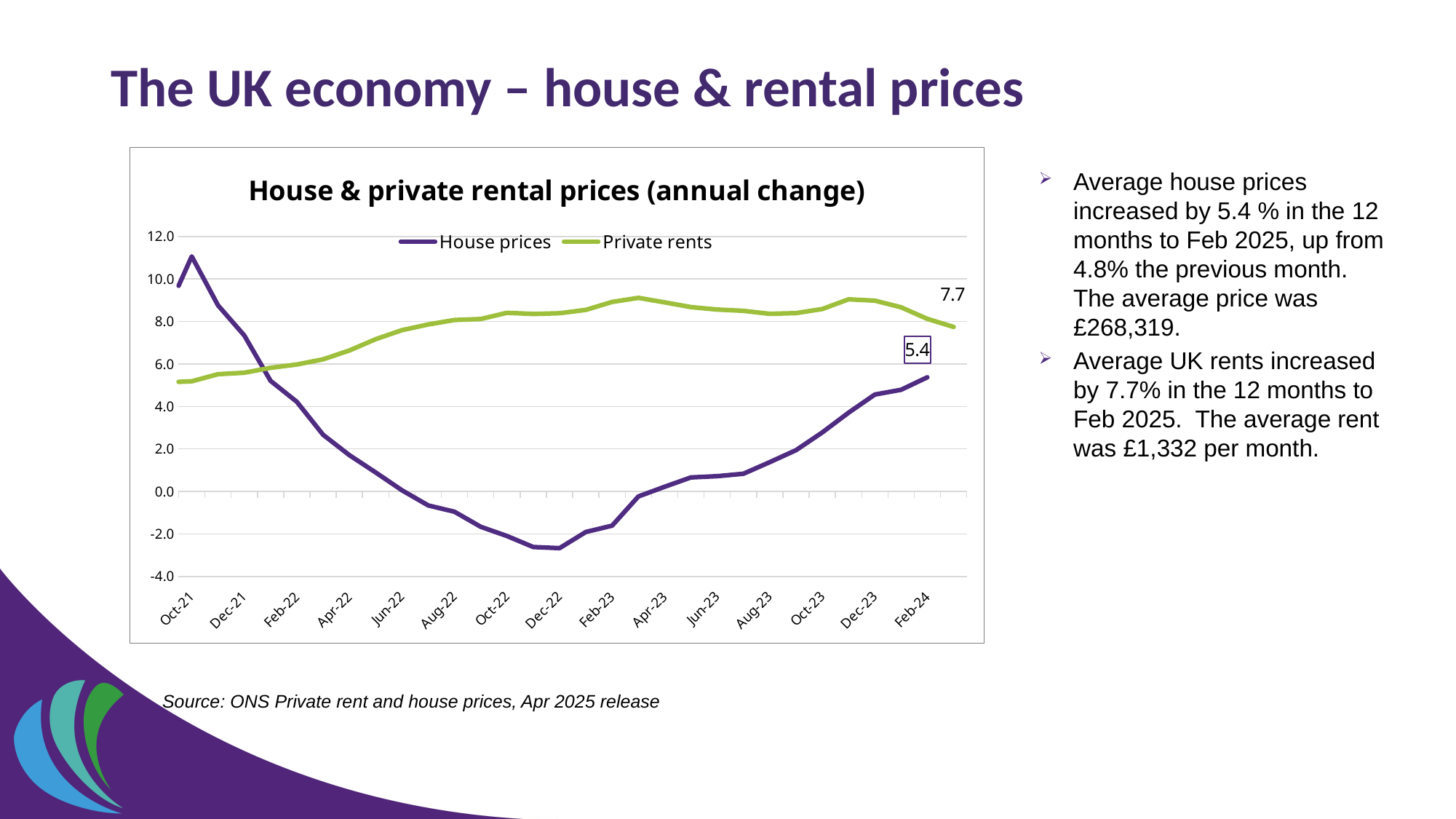
What is the difference between the final labelled values of Private rents (7.7) and House prices (5.4)? 2.3 Is the House prices value at Dec-22 greater or less than -2.0? less What is the labelled value of the House prices series at its final point on the chart? 5.4 What kind of chart is shown on the slide? line chart Which series reaches the highest value anywhere on the chart? House prices Is the Private rents value at Oct-21 greater or less than 6.0? less Does the House prices line rise or fall between Dec-21 and Dec-22? fall Is the House prices value at Oct-21 greater or less than 8.0? greater How many series does the chart's legend list? 2 At the final point on the chart, which series has the higher value, House prices or Private rents? Private rents What is the labelled value of the Private rents series at its final point on the chart? 7.7 What is the title of the chart? House & private rental prices (annual change)